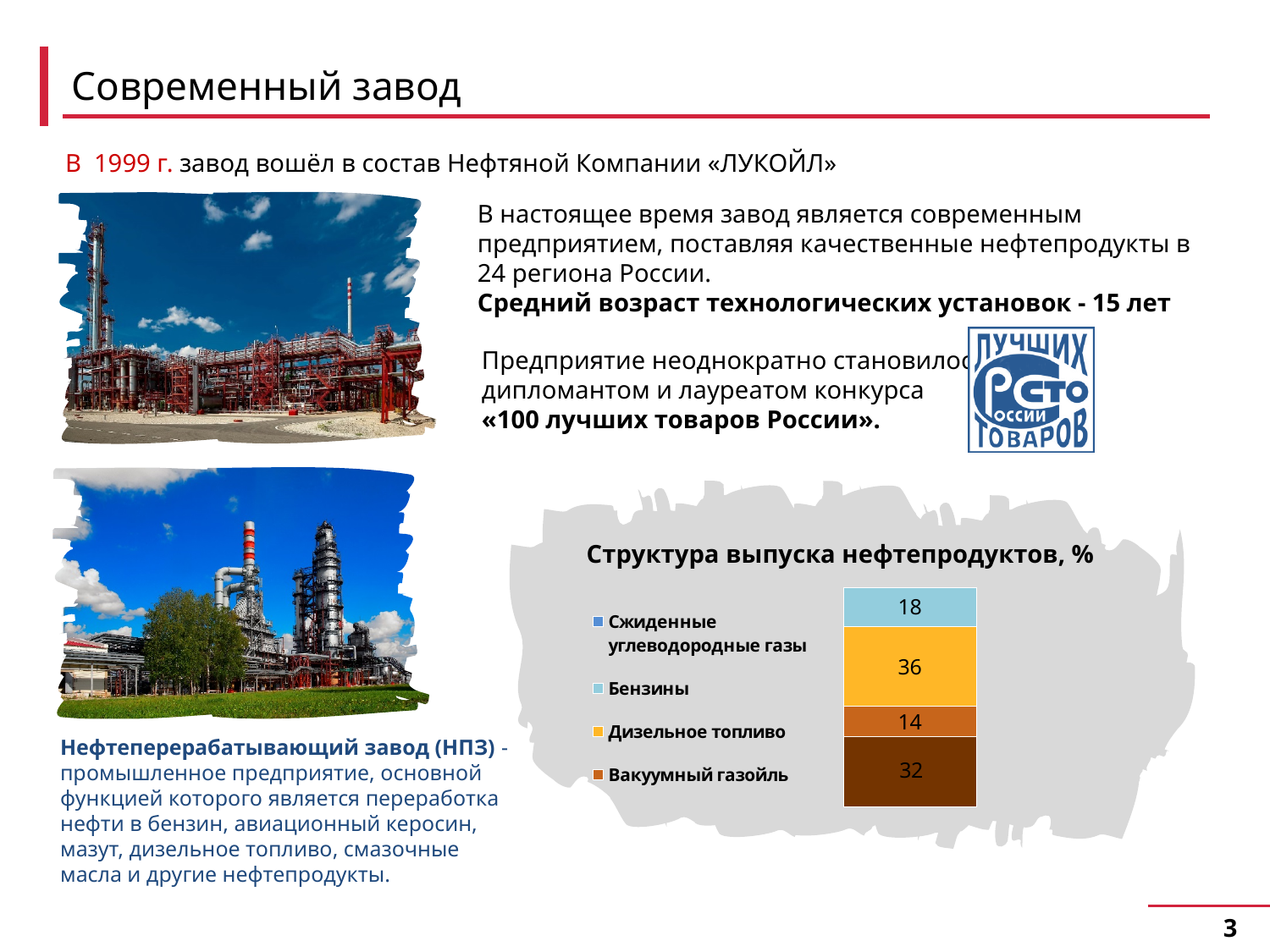
What is the difference between the largest and smallest segment values in the stacked bar? 22 Which is larger: the bottom segment (32) or the top segment (18) of the stacked bar? the bottom segment (32) What is the largest value shown in the stacked bar? 36 Which series is listed first in the chart legend? Сжиденные углеводородные газы What is the total of all segments in the stacked bar? 100 How many segments make up the stacked bar in the chart? 4 What is the value of the topmost segment of the stacked bar? 18 What kind of chart is shown on the slide? stacked bar chart What is the title of the chart on the slide? Структура выпуска нефтепродуктов, % What is the smallest value shown in the stacked bar? 14 How many series does the chart legend list? 4 What is the value of the bottom segment of the stacked bar? 32